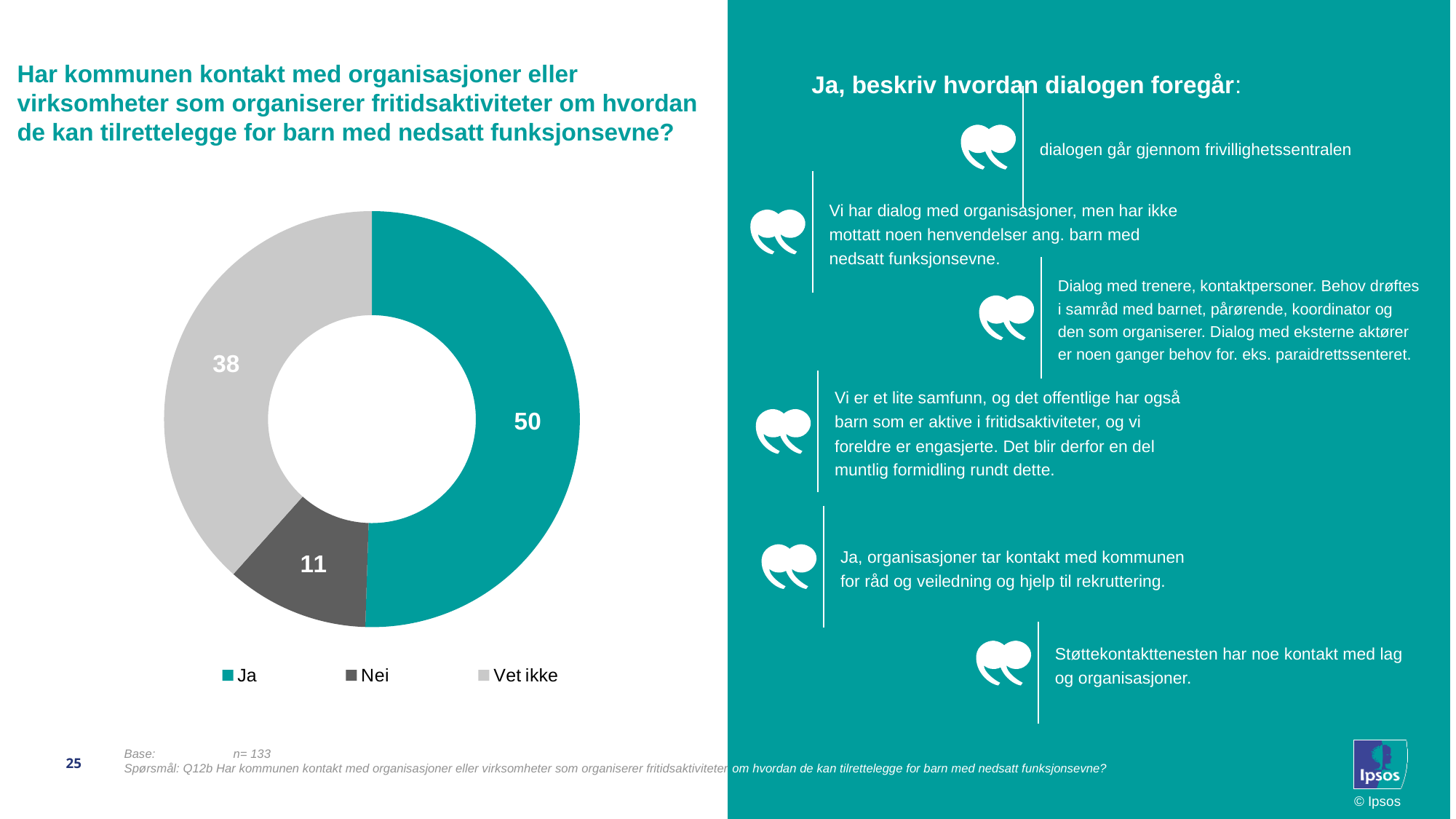
What colour is the "Ja" slice in the pie chart? Teal What kind of chart is shown on the slide? Pie chart (donut) What value is shown for the "Nei" slice of the pie chart? 11 How many categories does the pie chart show? 3 What is the difference between the values for "Ja" and "Vet ikke"? 12 What is the difference between the values for "Vet ikke" and "Nei"? 27 What value is shown for the "Vet ikke" slice of the pie chart? 38 Which category has the smallest slice in the pie chart? Nei What are the three legend entries of the chart? Ja, Nei, Vet ikke What value is shown for the "Ja" slice of the pie chart? 50 Which category has the largest slice in the pie chart? Ja Which is larger, the value for "Nei" or the value for "Vet ikke"? Vet ikke